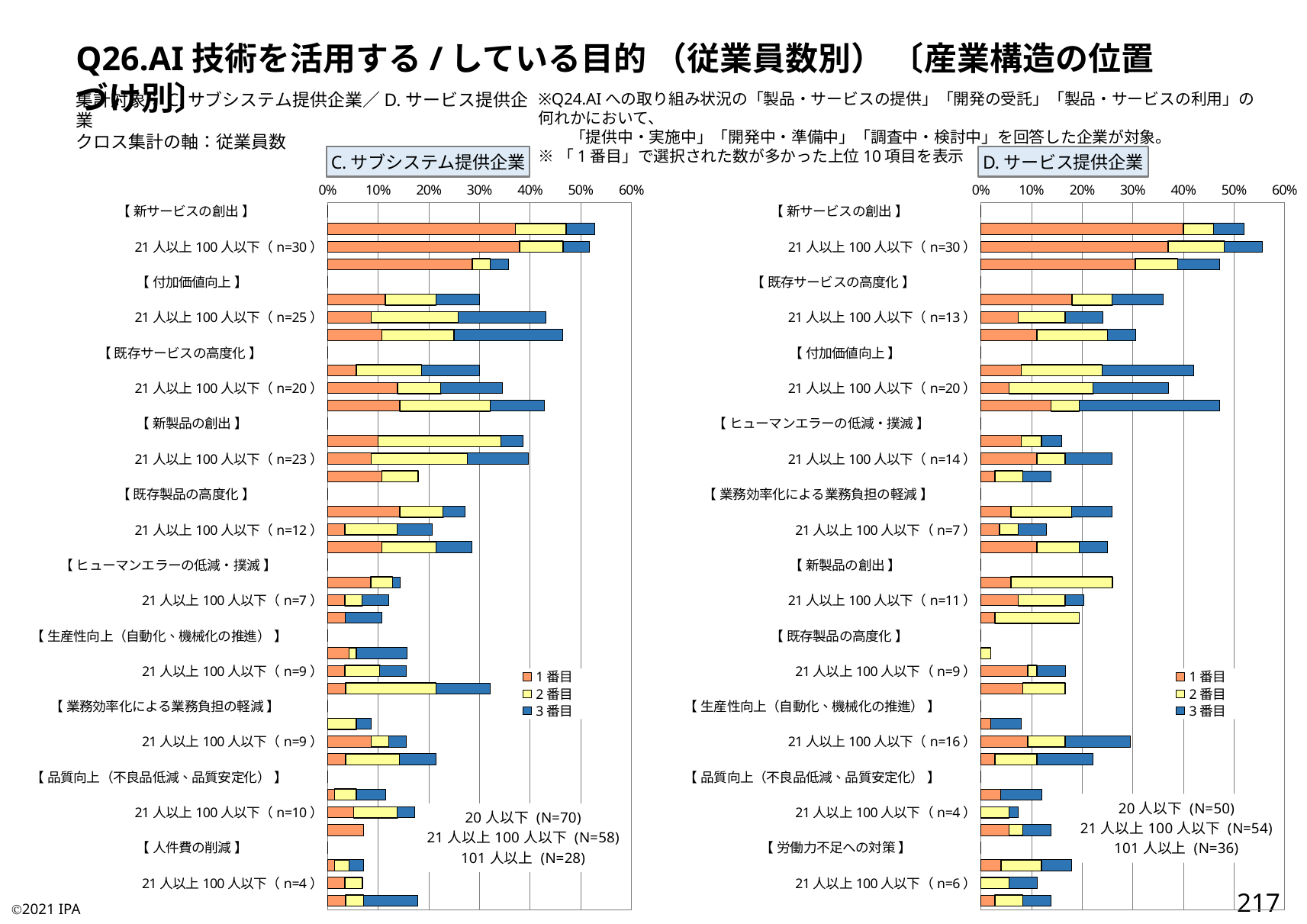
How many purpose categories (【 】 headings) are shown in the C. サブシステム提供企業 chart? 10 How many series does the legend list in the D. サービス提供企業 chart? 3 What is the sample size (N) for 21人以上100人以下 in the D. サービス提供企業 chart? N=54 What are the legend entries in the C. サブシステム提供企業 chart? 1番目, 2番目, 3番目 In the C. サブシステム提供企業 chart, is the total bar for 新サービスの創出 (21人以上100人以下, n=30) greater or less than 50%? greater In the D. サービス提供企業 chart, which purpose category has the longest total bar? 新サービスの創出 What kind of chart is used on this slide for C. サブシステム提供企業? Stacked bar chart In the D. サービス提供企業 chart, is the total bar for 新サービスの創出 (21人以上100人以下, n=30) greater or less than 50%? greater In the D. サービス提供企業 chart, is the total bar for 付加価値向上 (21人以上100人以下, n=20) greater or less than 30%? greater In the C. サブシステム提供企業 chart, which is larger: the total bar for 新サービスの創出 (21人以上100人以下) or for 品質向上 (21人以上100人以下)? 新サービスの創出 In the C. サブシステム提供企業 chart, which purpose category has the longest total bar? 新サービスの創出